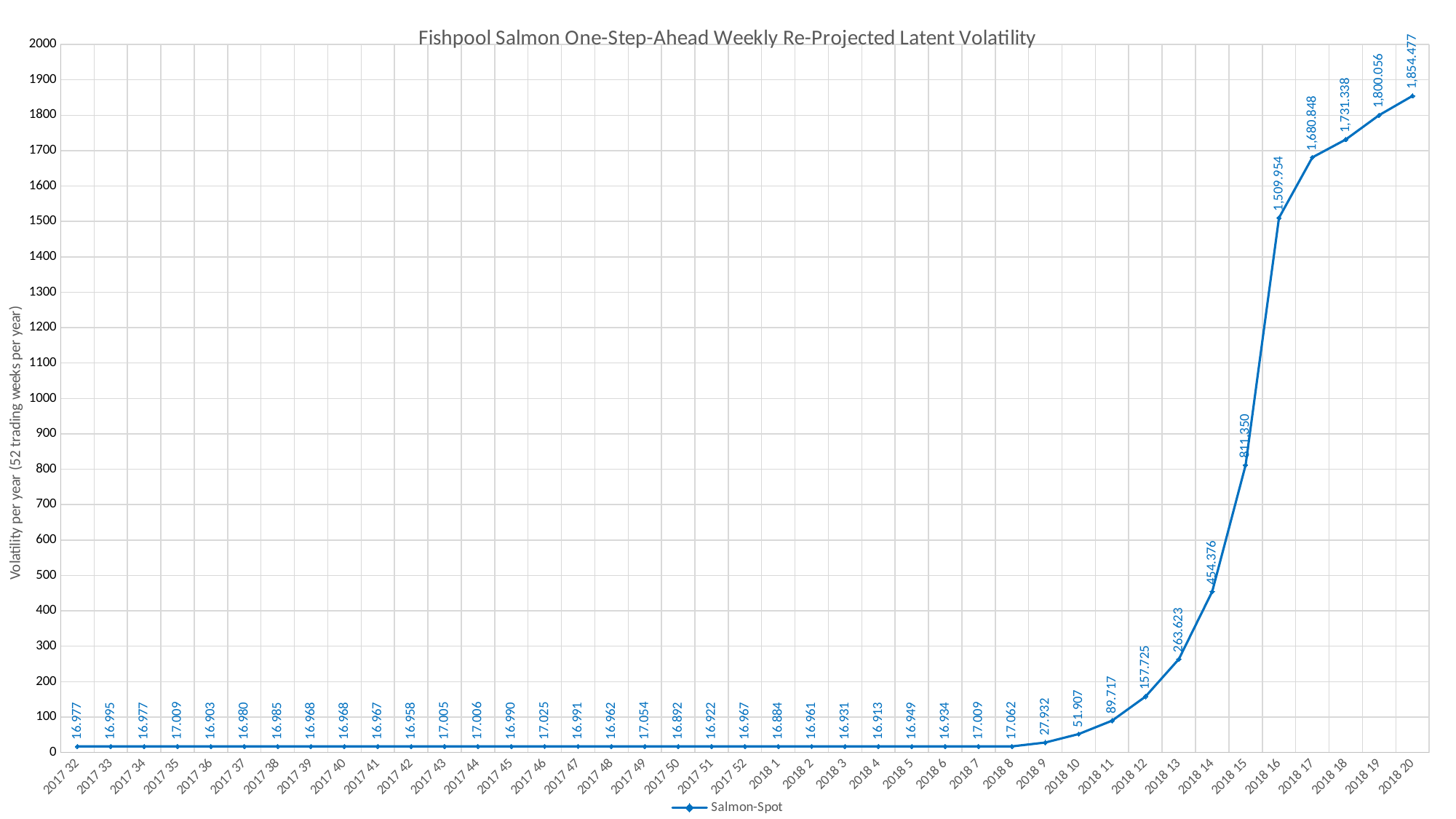
What is the value for 2018 20? 1,854.477 Which category has the highest value? 2018 20 How many series does the legend list? 1 What is the difference between the values for 2018 16 and 2018 15? 698.604 What type of chart is shown on the slide? line chart Is the value for 2018 17 greater or less than 1500? greater What is the value for 2018 15? 811.350 What is the title of the chart? Fishpool Salmon One-Step-Ahead Weekly Re-Projected Latent Volatility What is the value for 2018 12? 157.725 What is the difference between the values for 2018 20 and 2018 19? 54.421 Which is larger, the value for 2018 14 or the value for 2018 13? 2018 14 What is the value for 2017 32? 16.977